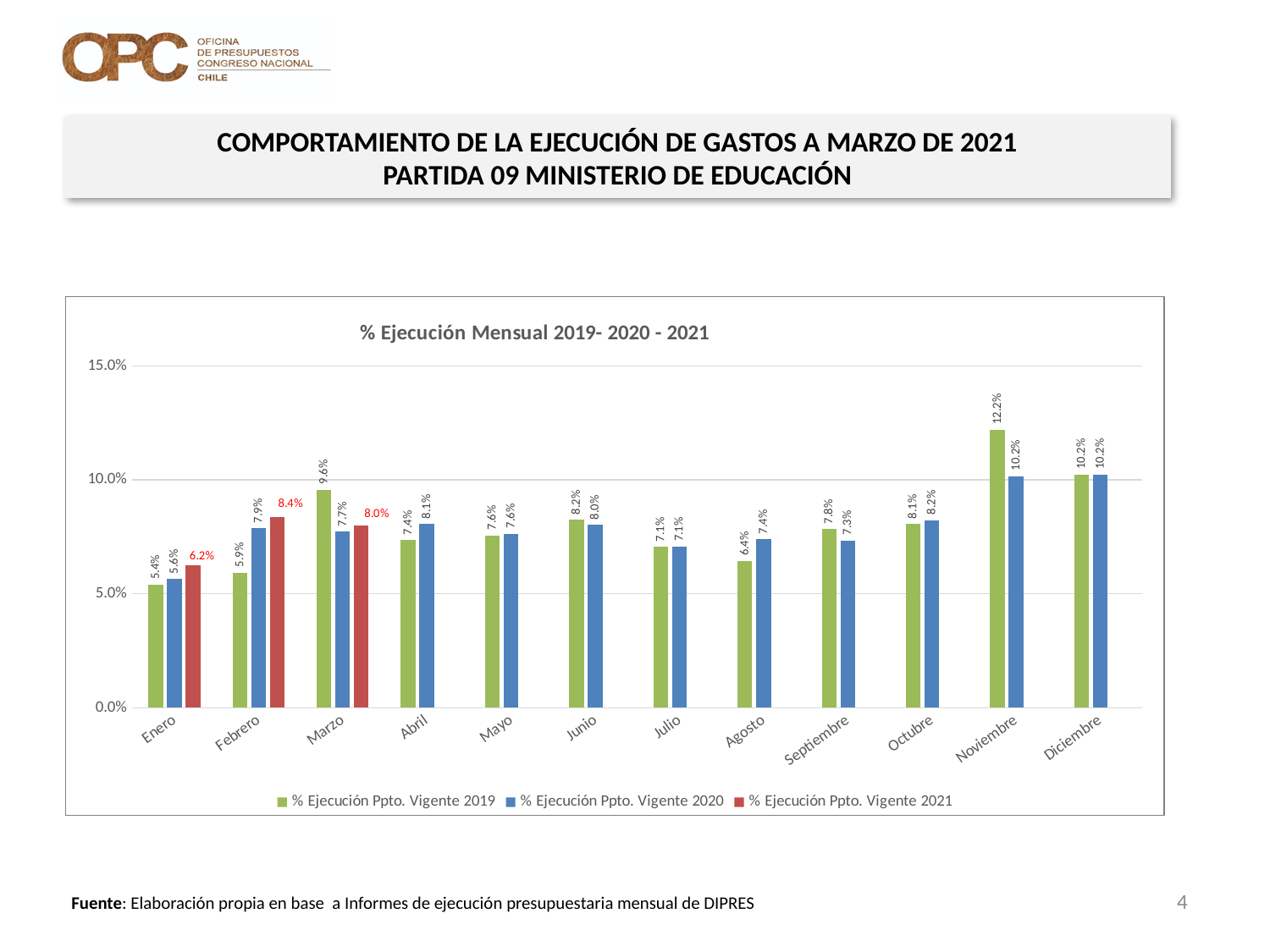
Which month has the lowest value for % Ejecución Ppto. Vigente 2020? Enero What is the value for % Ejecución Ppto. Vigente 2020 in Agosto? 7.4% How many months are shown on the x axis? 12 How many series does the legend list? 3 What is the value for % Ejecución Ppto. Vigente 2021 in Marzo? 8.0% Is the value for % Ejecución Ppto. Vigente 2019 in Noviembre greater or less than 10.0%? greater In Marzo, which series has the larger value: % Ejecución Ppto. Vigente 2019 or % Ejecución Ppto. Vigente 2021? % Ejecución Ppto. Vigente 2019 What is the title of the chart? % Ejecución Mensual 2019- 2020 - 2021 What is the difference between the 2019 and 2020 values in Noviembre? 2.0% What kind of chart is shown on the slide? Bar chart What is the value for % Ejecución Ppto. Vigente 2019 in Noviembre? 12.2% Which month has the highest value for % Ejecución Ppto. Vigente 2019? Noviembre